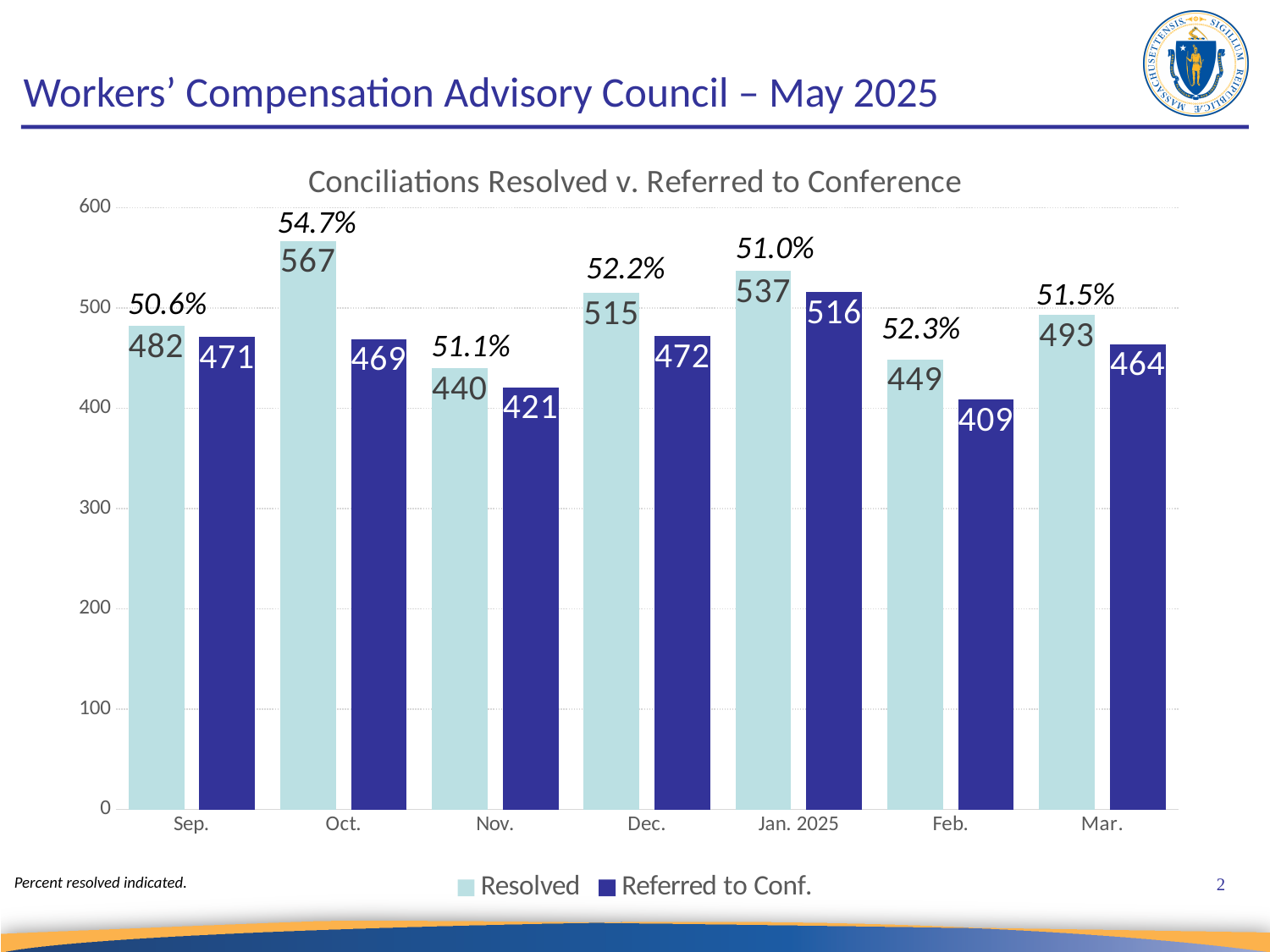
What is the difference between the Resolved and Referred to Conf. values for Jan. 2025? 21 Is the Referred to Conf. value for Mar. greater or less than 500? less Which month has the lowest Referred to Conf. value? Feb. Which is larger for Nov., the Resolved value or the Referred to Conf. value? Resolved What is the Referred to Conf. value for Feb.? 409 Which month has the highest Resolved value? Oct. What kind of chart is shown on the slide? bar chart How many months are shown on the x axis? 7 What is the title of the chart? Conciliations Resolved v. Referred to Conference What percent resolved is indicated for Dec.? 52.2% How many series does the legend list? 2 What is the Resolved value for Oct.? 567